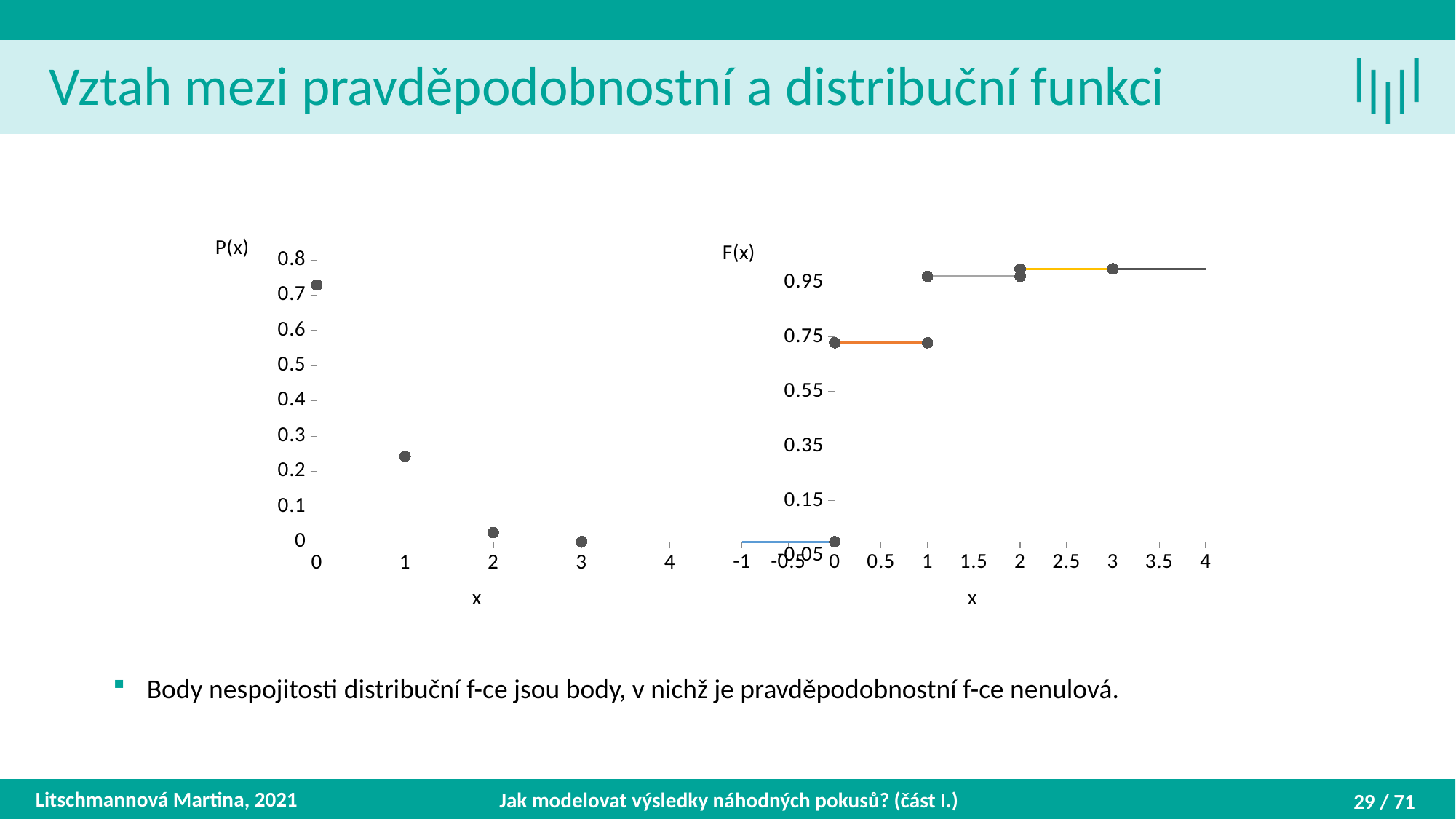
In the left chart, P(x), at which x value is the plotted value highest? 0 In the left chart, P(x), which has the larger value, x = 1 or x = 2? x = 1 In the left chart, P(x), is the value at x = 2 greater or less than 0.1? less In the right chart, F(x), which is larger, the value at x = 3 or the value at x = 0? x = 3 In the left chart, P(x), at which x value is the plotted value lowest? 3 In the right chart, F(x), do the values rise or fall as x increases? rise What kind of chart is the left chart, P(x)? scatter plot In the left chart, P(x), how many data points are plotted? 4 In the left chart, P(x), is the value at x = 0 greater or less than 0.6? greater In the left chart, P(x), do the values rise or fall as x increases? fall In the right chart, F(x), is the value on the step between x = 0 and x = 1 greater or less than 0.55? greater